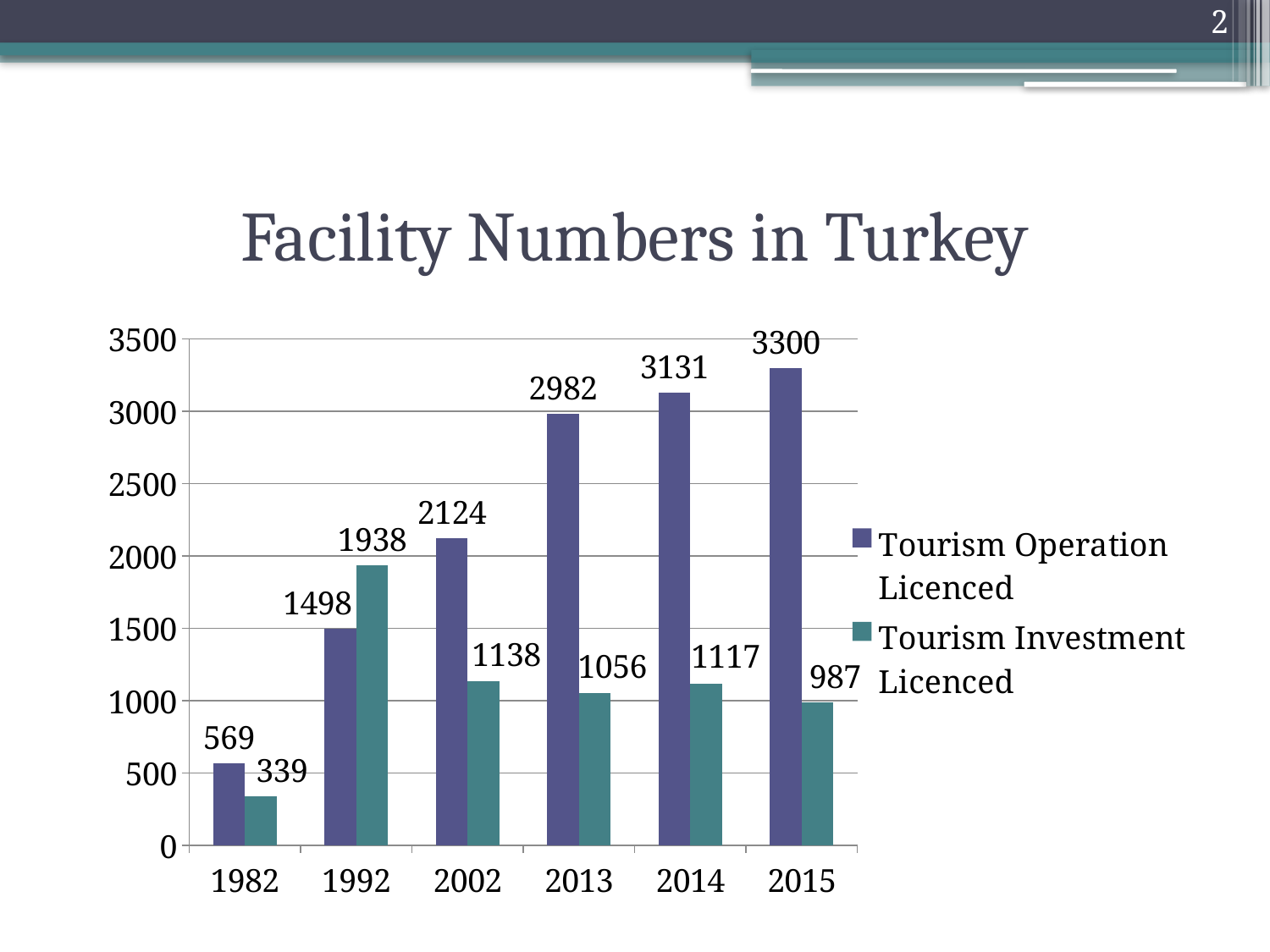
What is the difference between Tourism Operation Licenced and Tourism Investment Licenced in 2014? 2014 What is the value for Tourism Operation Licenced in 2015? 3300 Does the value for Tourism Operation Licenced rise or fall from 1982 to 2015? rise What is the value for Tourism Investment Licenced in 1982? 339 How many years are shown on the x axis? 6 How many series does the legend list? 2 Which year has the highest value for Tourism Operation Licenced? 2015 Which is larger in 1992: Tourism Operation Licenced or Tourism Investment Licenced? Tourism Investment Licenced What kind of chart is shown on the slide? bar chart What is the value for Tourism Investment Licenced in 1992? 1938 Which year has the lowest value for Tourism Investment Licenced? 1982 Is the value for Tourism Operation Licenced in 2013 greater or less than 2500? greater